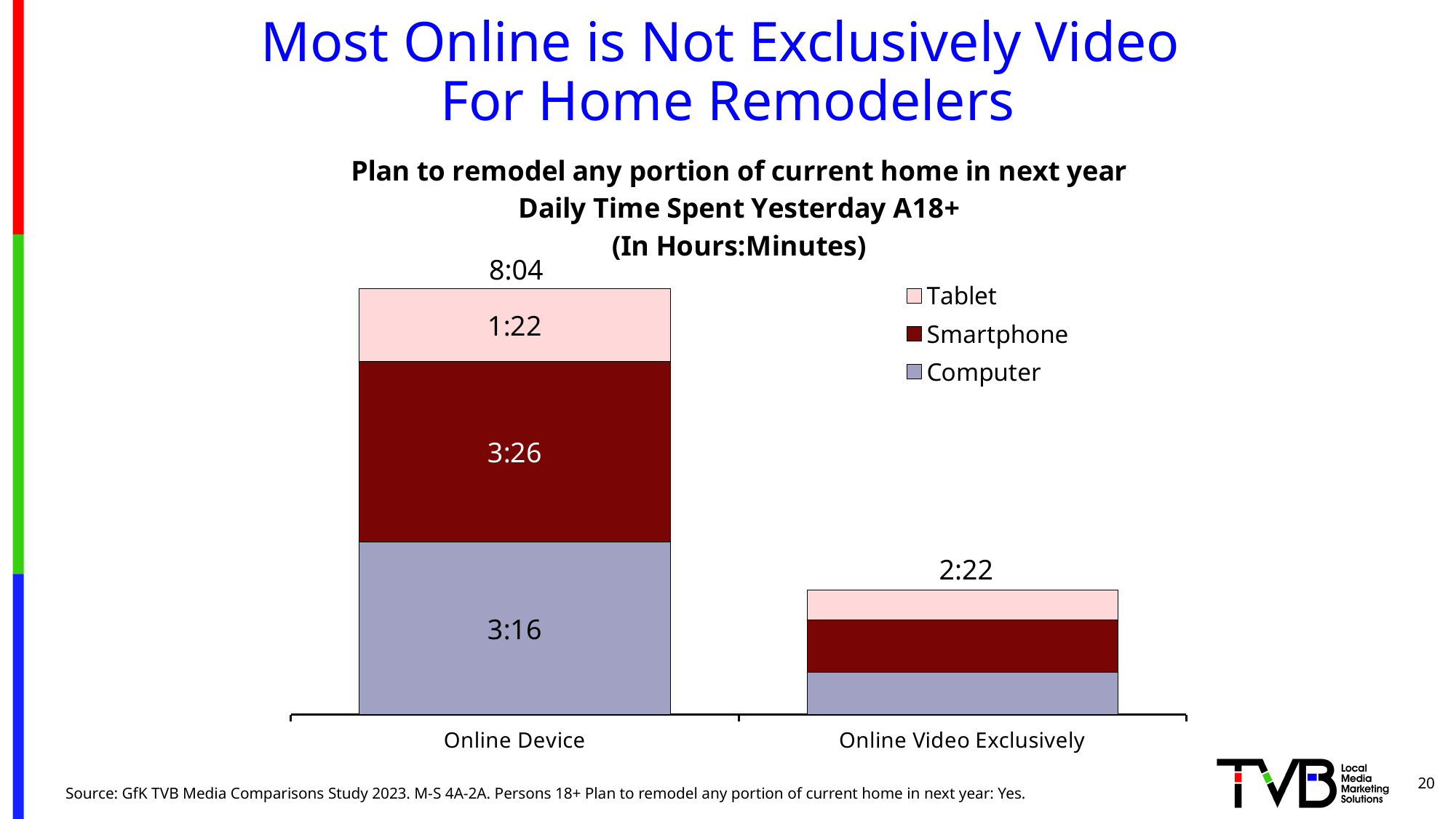
What is the total daily time spent for Online Device? 8:04 How many categories are shown on the x axis? 2 How many series does the legend list? 3 Within the Online Device bar, which device accounts for the most time? Smartphone What is the Tablet value for Online Device? 1:22 What is the Computer value for Online Device? 3:16 Within the Online Device bar, which device accounts for the least time? Tablet Which series is shown in the dark red colour? Smartphone What is the total daily time spent for Online Video Exclusively? 2:22 What kind of chart is shown on the slide? stacked bar chart What is the Smartphone value for Online Device? 3:26 Which category has the higher total daily time spent, Online Device or Online Video Exclusively? Online Device